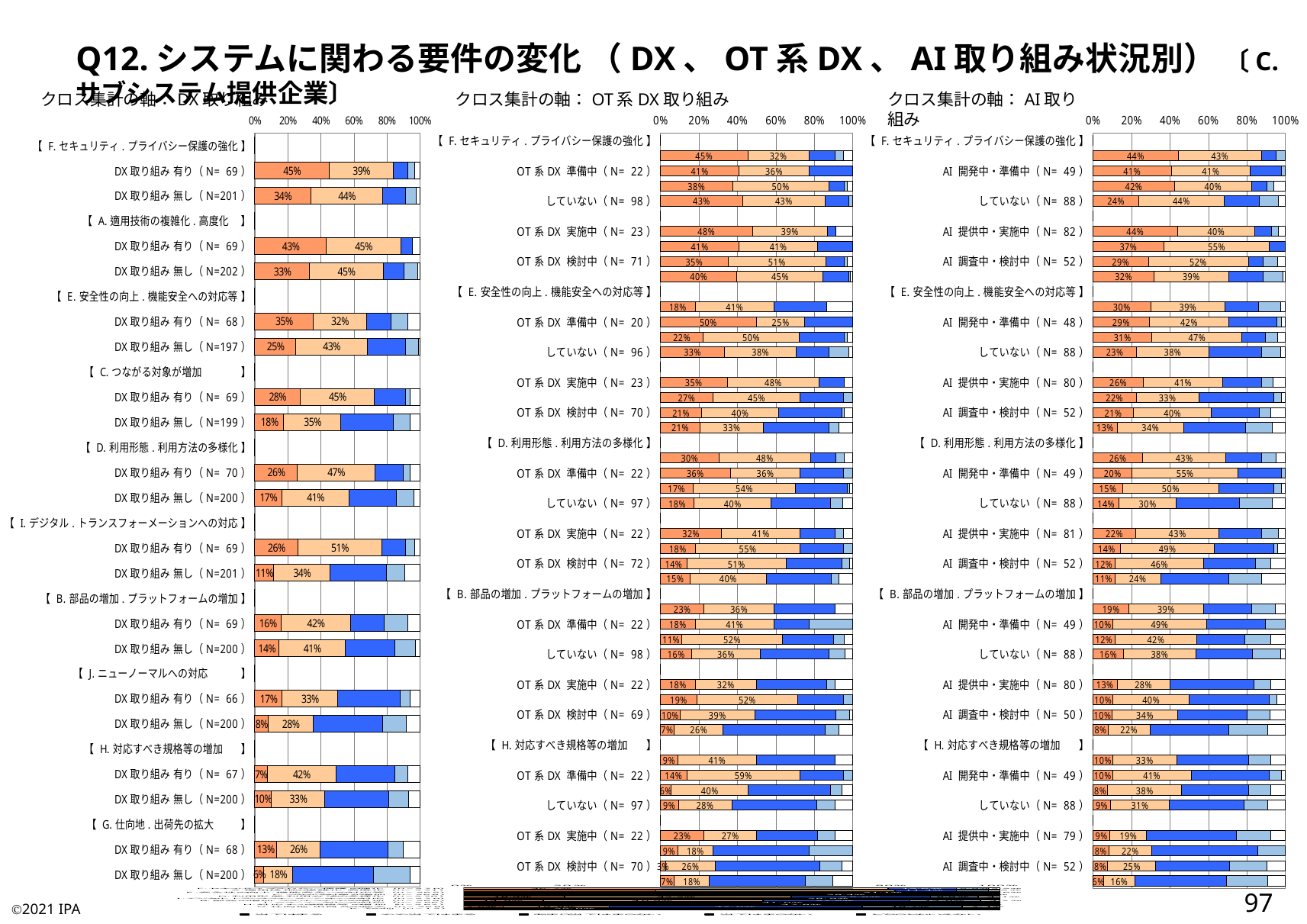
How many charts are shown on the slide? 3 In the left chart (クロス集計の軸: DX取り組み), what is the second segment value for DX取り組み有り (N=66) under J. ニューノーマルへの対応? 33% In the left chart (クロス集計の軸: DX取り組み), under I. デジタル.トランスフォーメーションへの対応, which has the larger first segment: DX取り組み有り or DX取り組み無し? DX取り組み有り In the left chart (クロス集計の軸: DX取り組み), what is the first segment value for DX取り組み有り (N=67) under H. 対応すべき規格等の増加? 7% In the left chart (クロス集計の軸: DX取り組み), under F. セキュリティ.プライバシー保護の強化, what is the difference between the first segment values of DX取り組み有り (45%) and DX取り組み無し (34%)? 11 percentage points In the left chart (クロス集計の軸: DX取り組み), what is the first (leftmost) segment value for DX取り組み有り (N=69) under F. セキュリティ.プライバシー保護の強化? 45% In the left chart (クロス集計の軸: DX取り組み), what is the second segment value for DX取り組み有り (N=69) under A. 適用技術の複雑化.高度化? 45% What kind of chart is used on this slide? Stacked horizontal bar chart What is the cross-tabulation axis (クロス集計の軸) of the rightmost chart? AI取り組み In the left chart (クロス集計の軸: DX取り組み), which category has the highest first segment value for DX取り組み有り? F. セキュリティ.プライバシー保護の強化 (45%) In the left chart (クロス集計の軸: DX取り組み), what is the second segment value for DX取り組み無し (N=201) under F. セキュリティ.プライバシー保護の強化? 44% In the left chart (クロス集計の軸: DX取り組み), what is the first segment value for DX取り組み無し (N=200) under G. 仕向地.出荷先の拡大? 6%